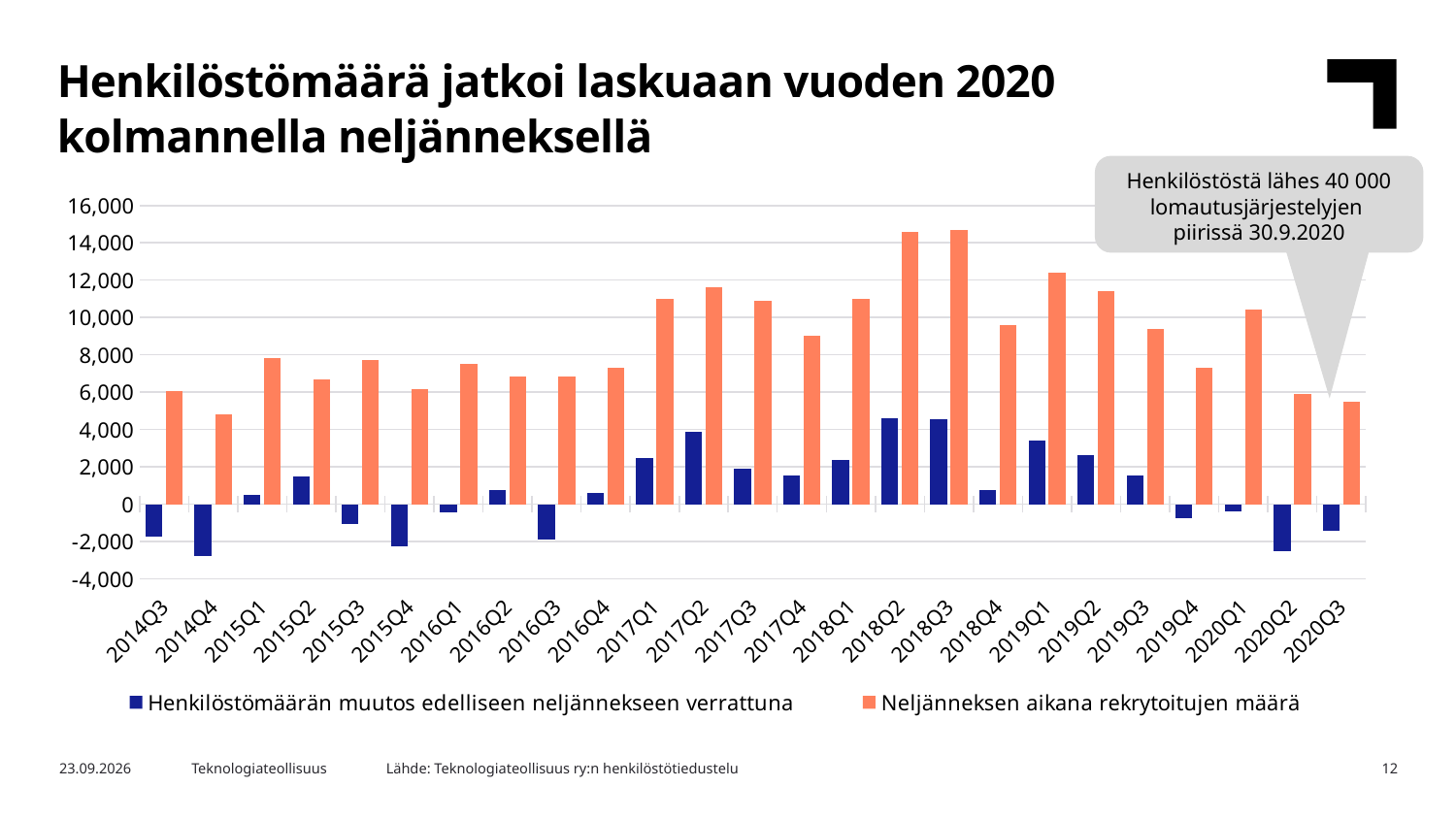
According to the callout on the chart, how many employees were covered by lay-off arrangements on 30.9.2020? Lähes 40 000 Which is larger for Neljänneksen aikana rekrytoitujen määrä: 2019Q1 or 2019Q2? 2019Q1 Is the value for Henkilöstömäärän muutos edelliseen neljännekseen verrattuna in 2017Q2 greater or less than 2,000? greater Is the value for Neljänneksen aikana rekrytoitujen määrä in 2020Q3 greater or less than 6,000? less What kind of chart is shown on the slide? Bar chart Does the value for Neljänneksen aikana rekrytoitujen määrä rise or fall from 2020Q1 to 2020Q3? Fall Which is larger for Neljänneksen aikana rekrytoitujen määrä: 2020Q1 or 2020Q2? 2020Q1 How many quarters are shown on the x axis? 25 Which quarter has the lowest value for Neljänneksen aikana rekrytoitujen määrä? 2014Q4 Is the value for Henkilöstömäärän muutos edelliseen neljännekseen verrattuna in 2020Q2 greater or less than -2,000? less How many series does the legend list? 2